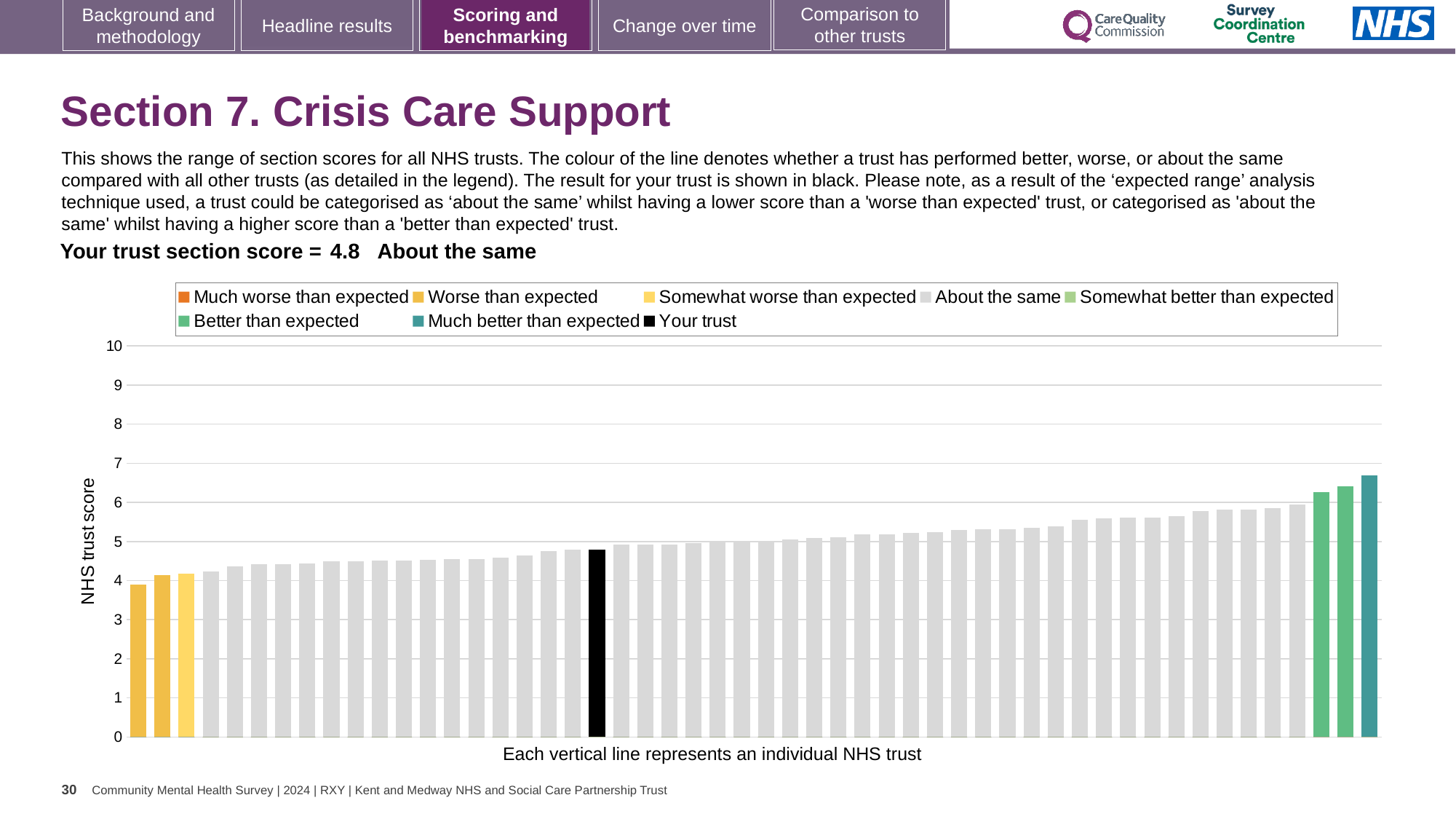
What kind of chart is shown on the slide? bar chart How many bars on the chart are coloured as 'Better than expected'? 2 What is the label of the y axis? NHS trust score Is the value of the black 'Your trust' bar greater or less than 5? less How many entries does the chart legend list? 8 Which legend category does the tallest bar on the chart belong to? Much better than expected What is the section score for your trust shown on the slide? 4.8 Is the value of the shortest bar on the chart greater or less than 4? less Which legend category does the shortest bar on the chart belong to? Worse than expected Do the bar values rise or fall from left to right along the x axis? rise Is the value of the tallest bar on the chart greater or less than 6? greater What colour is the bar representing your trust? black